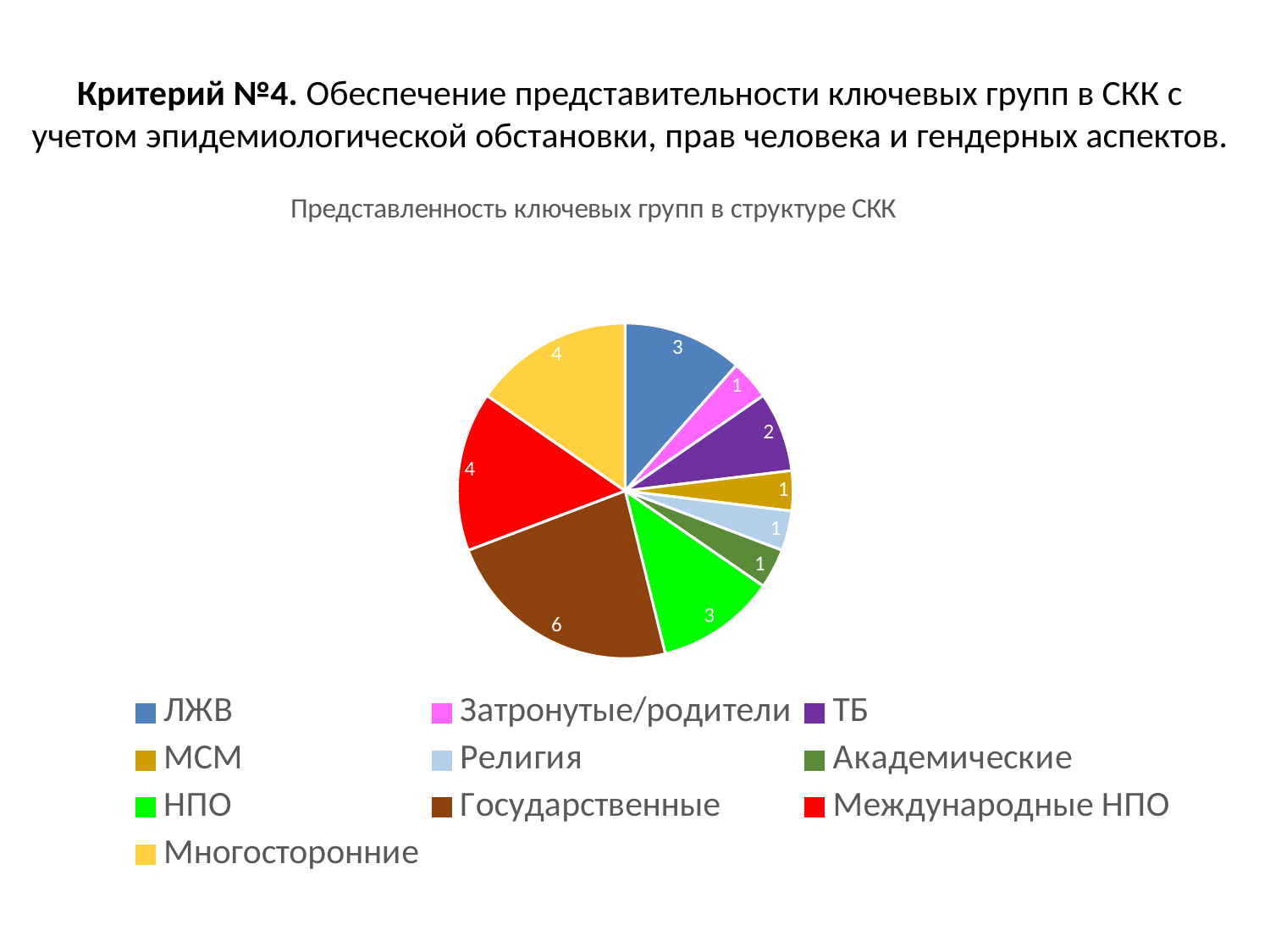
What is the value for Государственные in the pie chart? 6 Which category has the largest slice in the pie chart? Государственные What is the title of the pie chart? Представленность ключевых групп в структуре СКК What is the value for ТБ in the pie chart? 2 What is the difference between the values for Государственные and ЛЖВ? 3 What is the total of all the slice values in the pie chart? 26 What is the value for ЛЖВ in the pie chart? 3 Which is larger, the value for Международные НПО or the value for ТБ? Международные НПО What is the value for Международные НПО in the pie chart? 4 What is the value for МСМ in the pie chart? 1 What kind of chart is shown on the slide? pie chart How many categories does the pie chart have? 10